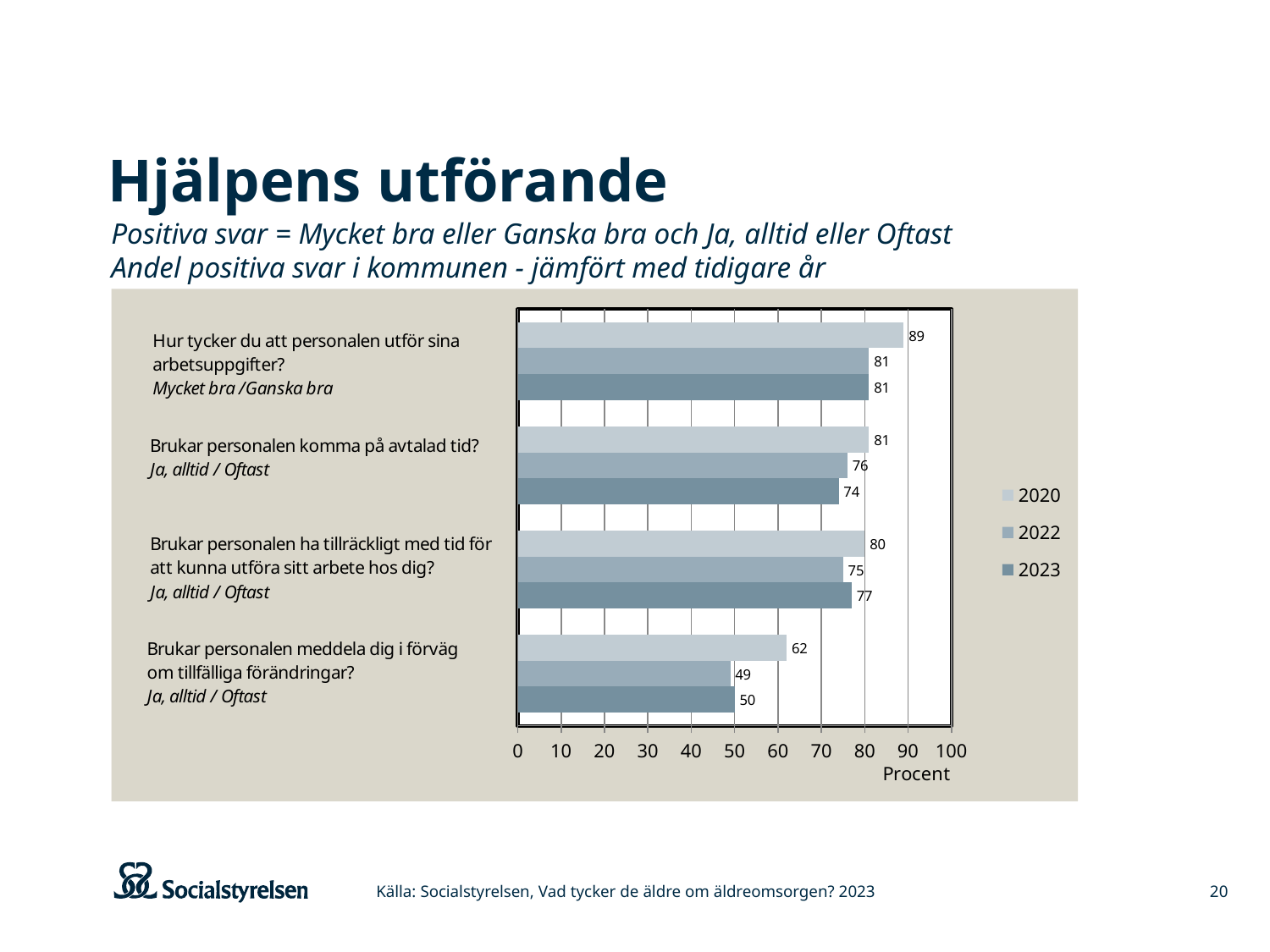
How many series does the legend list? 3 What label is shown on the horizontal axis of the chart? Procent What is the 2020 value for "Hur tycker du att personalen utför sina arbetsuppgifter?"? 89 How many question categories are plotted on the chart? 4 What is the difference between the 2020 and 2022 values for "Hur tycker du att personalen utför sina arbetsuppgifter?"? 8 What is the difference between the 2020 and 2023 values for "Brukar personalen meddela dig i förväg om tillfälliga förändringar?"? 12 What is the 2023 value for "Brukar personalen komma på avtalad tid?"? 74 Which question category has the highest 2020 value? Hur tycker du att personalen utför sina arbetsuppgifter? For "Brukar personalen ha tillräckligt med tid för att kunna utföra sitt arbete hos dig?", which is larger, the 2022 value or the 2023 value? 2023 Which question category has the lowest 2023 value? Brukar personalen meddela dig i förväg om tillfälliga förändringar? What is the 2022 value for "Brukar personalen meddela dig i förväg om tillfälliga förändringar?"? 49 What kind of chart is shown on the slide? Bar chart